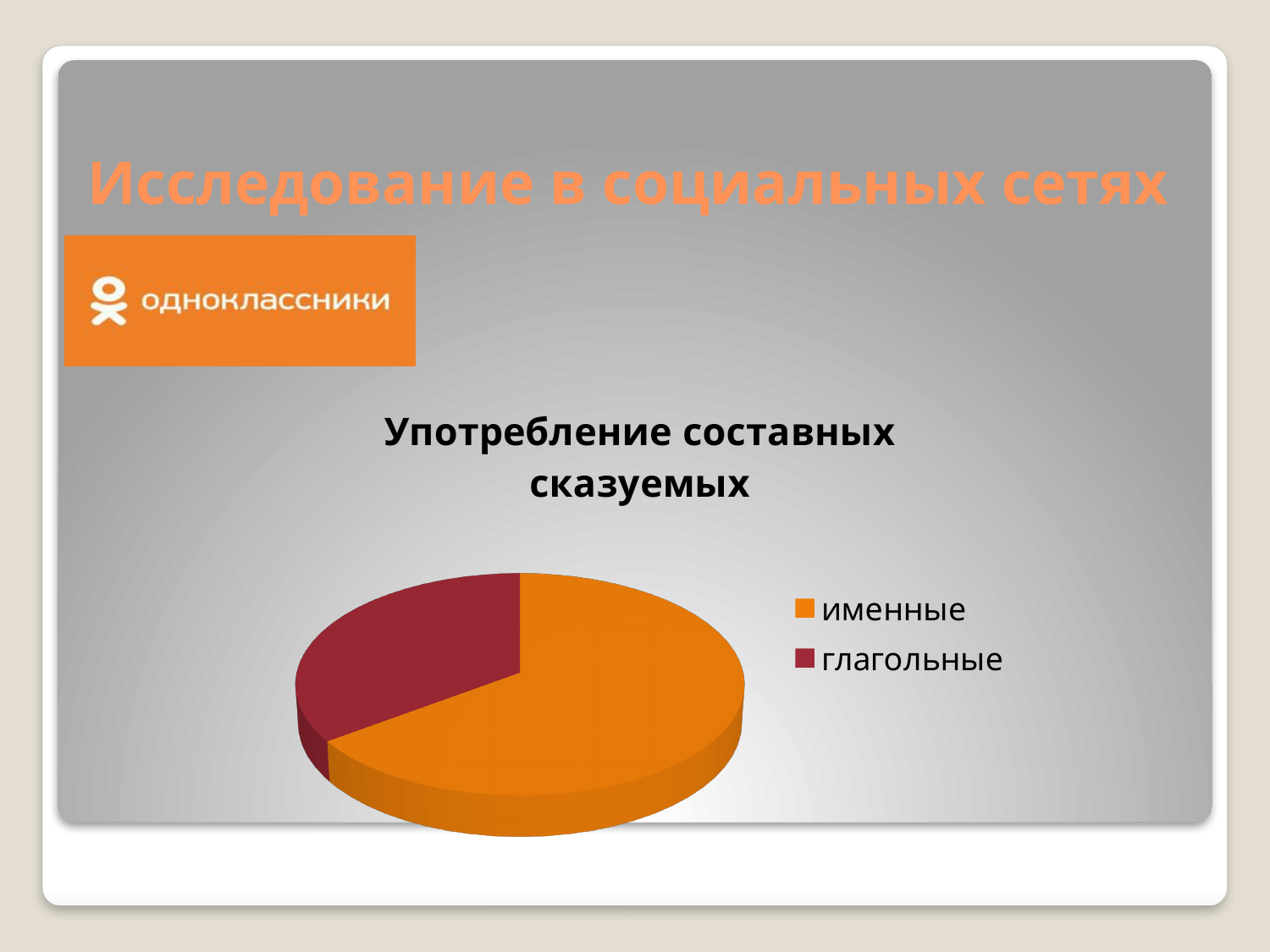
What is the title of the chart? Употребление составных сказуемых Does the slice for именные take up more or less than half of the pie? more What colour is the slice for глагольные? dark red Which category has the smallest slice of the pie? глагольные How many slices does the pie chart have? 2 Which slice is larger, именные or глагольные? именные What kind of chart is shown on the slide? pie chart How many entries does the chart legend list? 2 Which category has the largest slice of the pie? именные